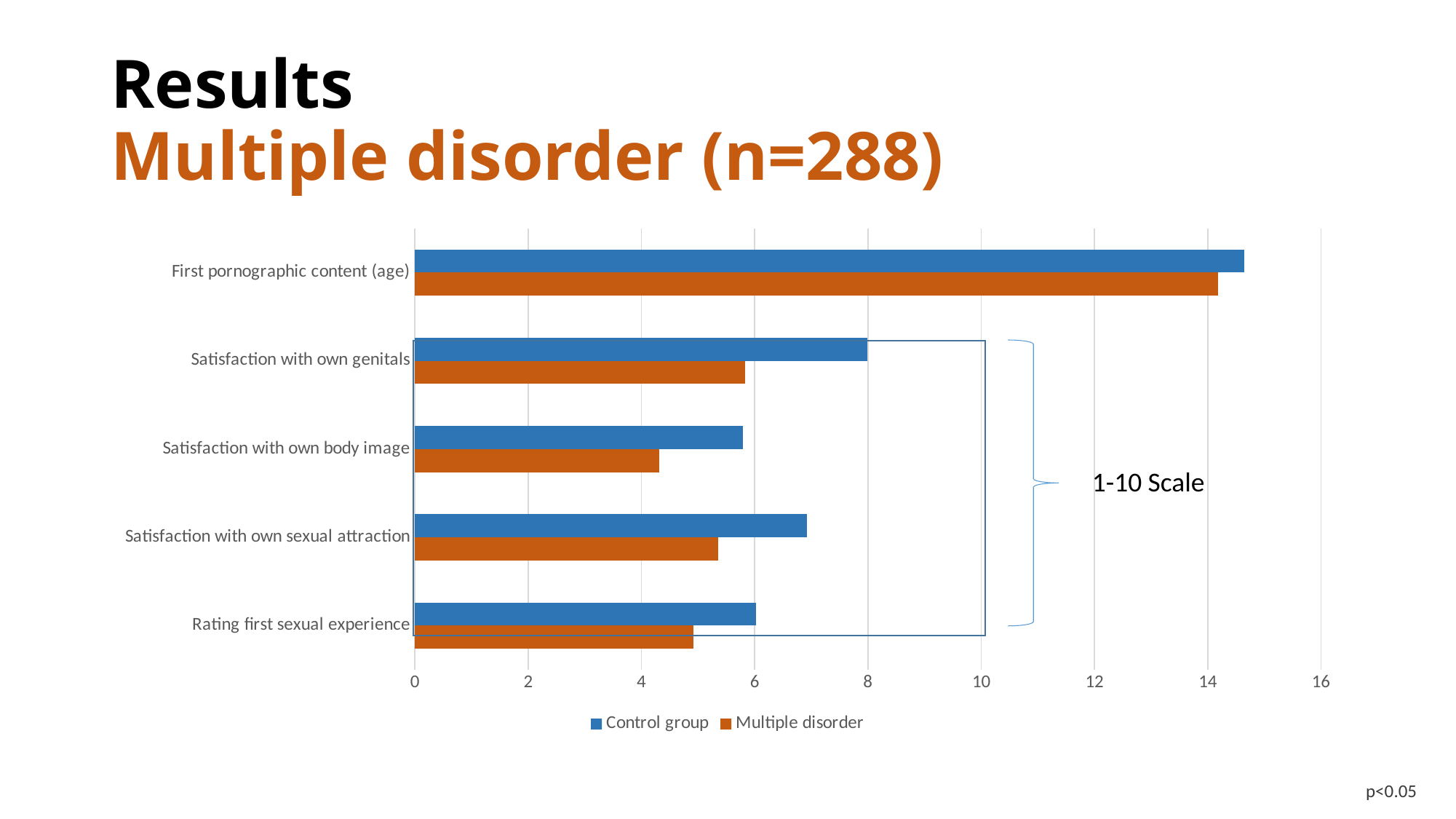
What does the bracket annotation to the right of the lower four categories say? 1-10 Scale Is the Multiple disorder value for First pornographic content (age) greater or less than 12? greater Is the Control group value for Satisfaction with own sexual attraction greater or less than 6? greater What kind of chart is shown on the slide? bar chart For Satisfaction with own genitals, which is larger: the Control group value or the Multiple disorder value? Control group Which category has the highest value for the Control group? First pornographic content (age) Which category has the lowest value for Multiple disorder? Satisfaction with own body image Is the Control group value for Rating first sexual experience greater or less than 8? less How many categories are plotted on the chart? 5 What are the two series named in the legend? Control group and Multiple disorder How many series does the legend list? 2